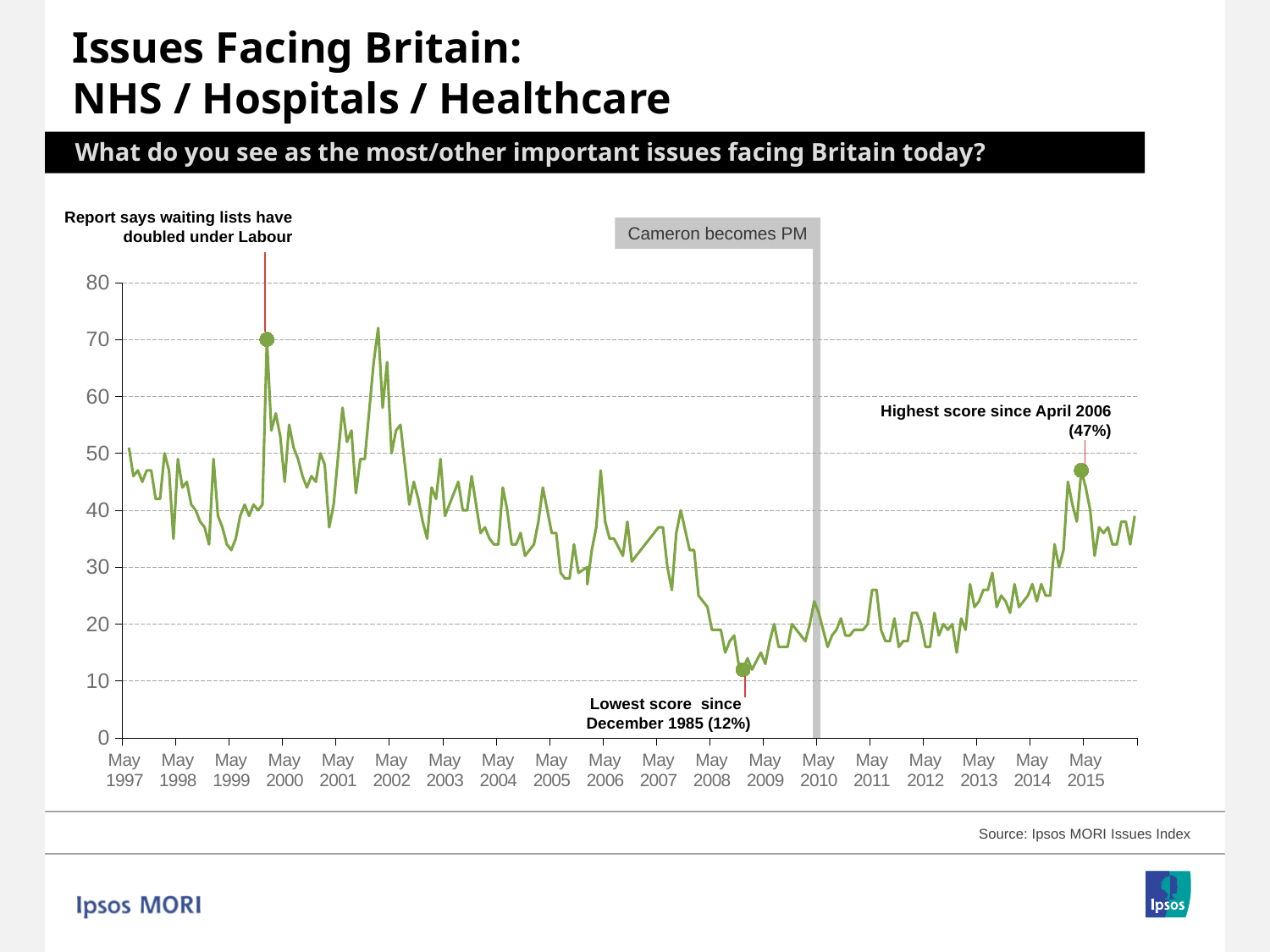
In which year does the line reach its lowest point? 2008 Which is larger: the annotated score in 2015 or the annotated score in 2008? the 2015 score (47%) What is the difference between the annotated highest score since April 2006 and the annotated lowest score since December 1985? 35 percentage points What value is given for the lowest score since December 1985? 12% What value is given for the highest score since April 2006? 47% Is the value at May 2012 greater or less than 40? less What does the annotation above the peak near 2000 say? Report says waiting lists have doubled under Labour Is the value at May 1997 greater or less than 40? greater Is the value at May 2010 greater or less than 40? less What event does the grey vertical band on the chart mark? Cameron becomes PM Do the values rise or fall between May 2013 and May 2015? rise What kind of chart is shown on the slide? line chart